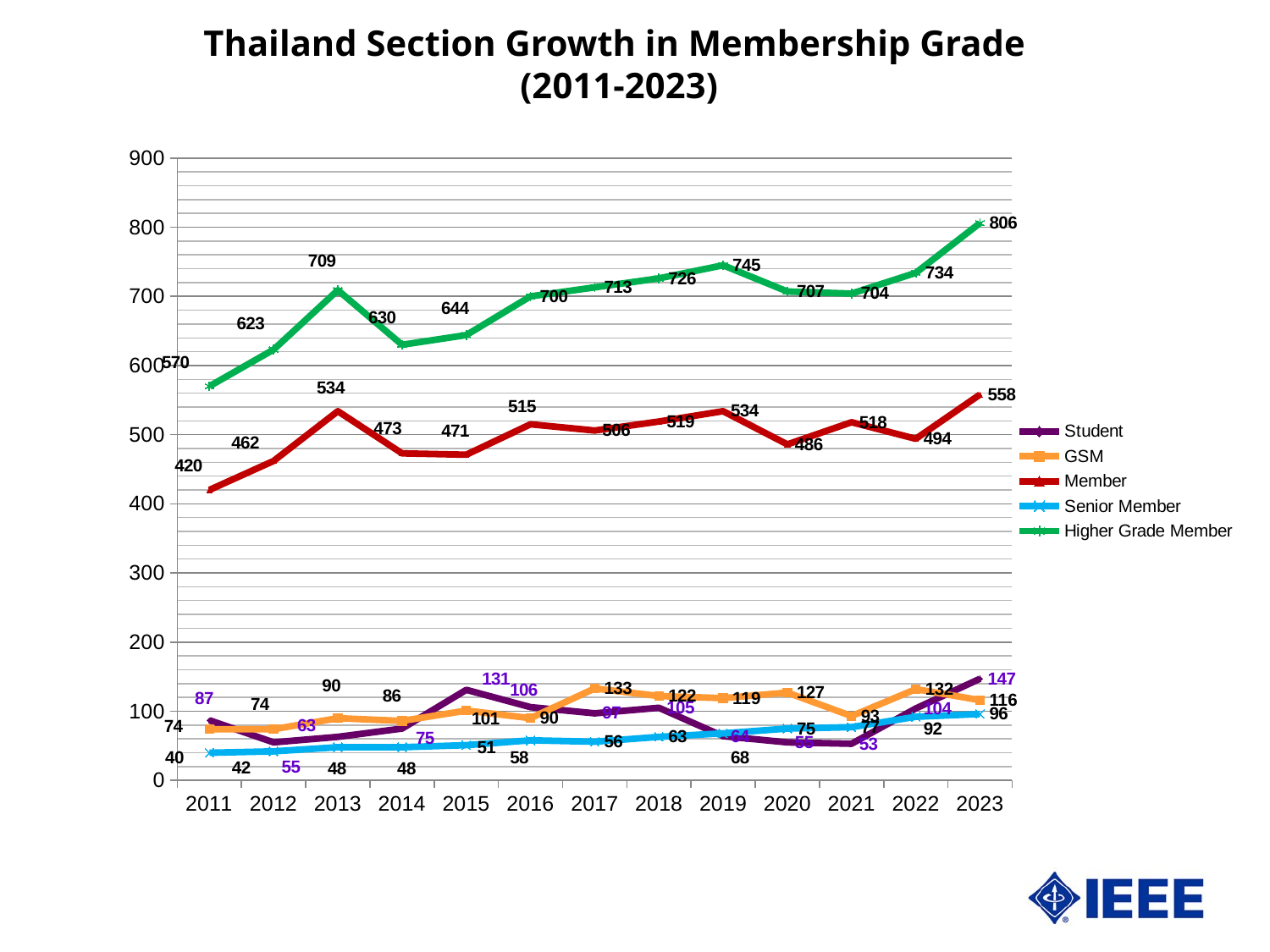
What type of chart is shown on the slide? Line chart How many series does the legend list? 5 What is the difference between the Higher Grade Member values in 2023 and 2011? 236 In which year is the Member value lowest? 2011 What is the value for Higher Grade Member in 2023? 806 Overall, does the Higher Grade Member line rise or fall from 2011 to 2023? rise Is the value for Senior Member in 2011 greater or less than 100? less What is the value for Higher Grade Member in 2019? 745 In 2013, which is larger: the Member value or the Higher Grade Member value? Higher Grade Member How many years are plotted along the x axis? 13 What is the value for Member in 2011? 420 In which year is the Higher Grade Member value highest? 2023